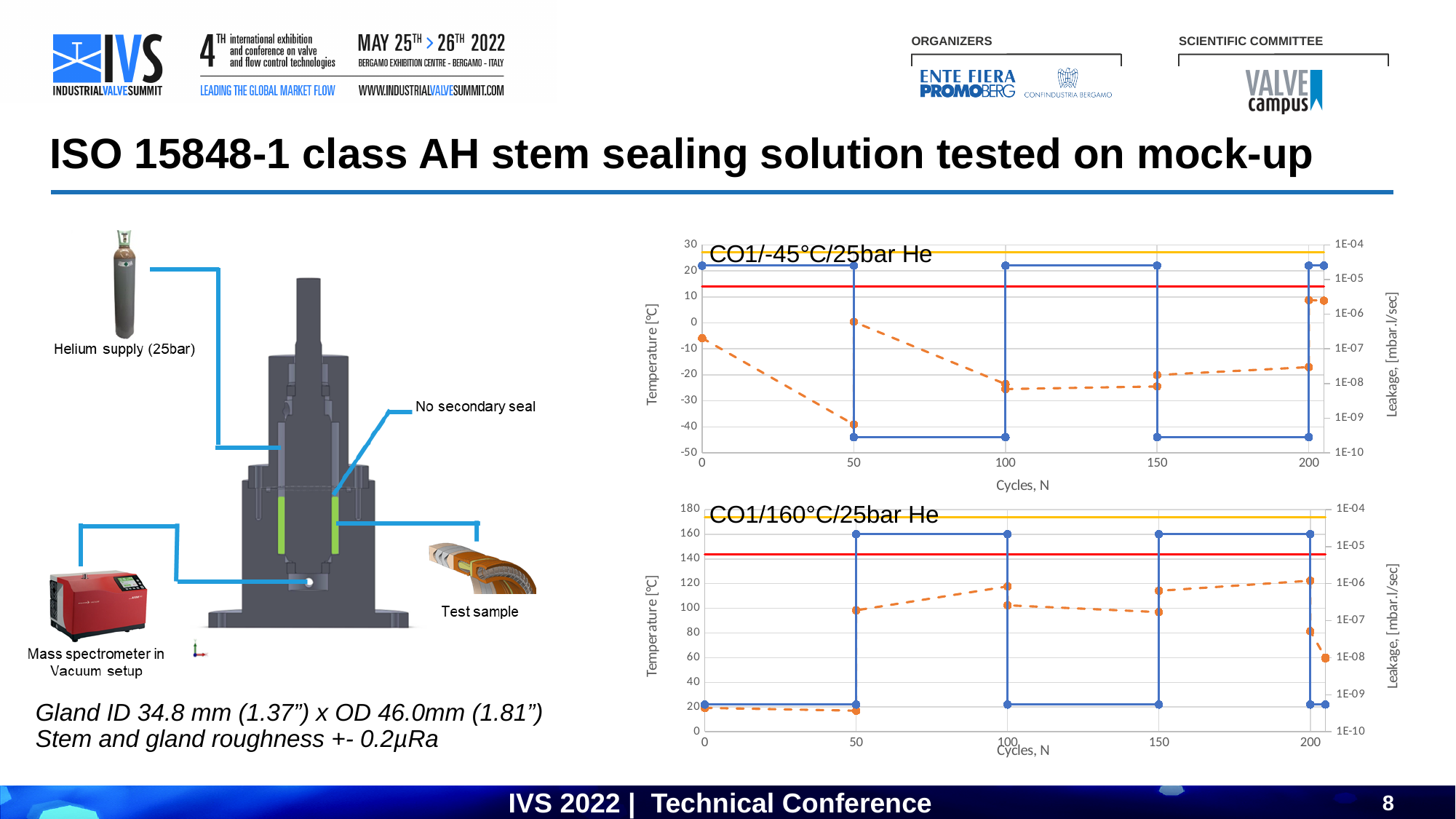
In the top chart (CO1/-45°C/25bar He), does the dashed leakage line rise or fall between 0 and 50 cycles? fall In the top chart (CO1/-45°C/25bar He), is the lowest temperature reached by the blue line greater or less than -40? less In the top chart (CO1/-45°C/25bar He), is the highest temperature reached by the blue line greater or less than 10? greater In the bottom chart (CO1/160°C/25bar He), is the temperature of the blue line at 0 cycles greater or less than 40? less How many charts are shown on the slide? 2 In the bottom chart (CO1/160°C/25bar He), what is the label of the right-hand y axis? Leakage, [mbar.l/sec] What kind of chart is the top chart titled CO1/-45°C/25bar He? line chart In the top chart (CO1/-45°C/25bar He), what is the label of the x axis? Cycles, N In the bottom chart (CO1/160°C/25bar He), does the dashed leakage line rise or fall between 0 and 100 cycles? rise